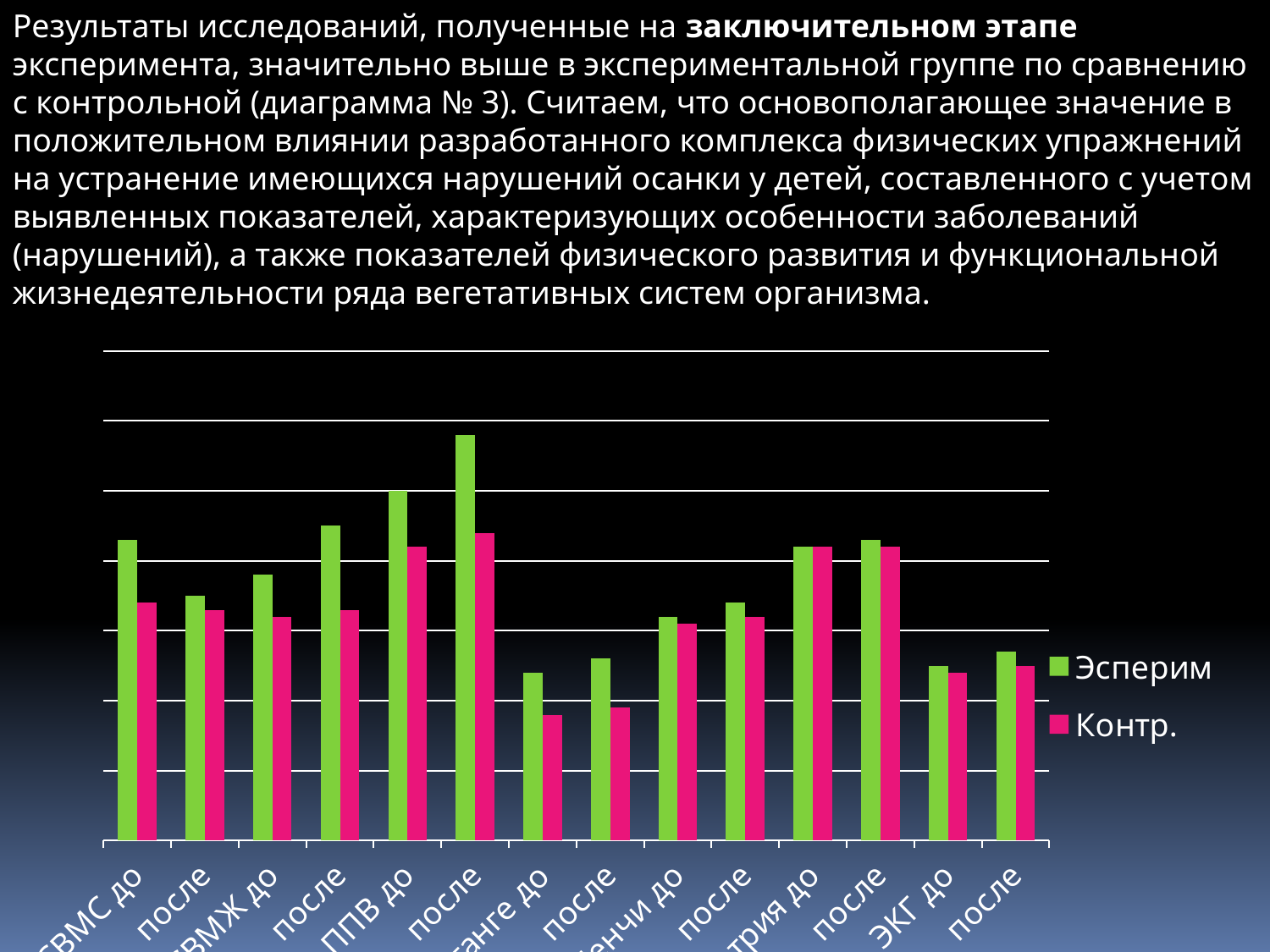
Which series is shown in green in the chart? Эсперим Which category has the highest Эсперим value in the chart? the 'после' category immediately after 'ППВ до' What kind of chart is shown on the slide? bar chart For the 'после' category immediately following 'ППВ до', which series has the larger value, Эсперим or Контр.? Эсперим Which series is shown in pink in the chart? Контр. For the category 'ППВ до', which series has the larger value, Эсперим or Контр.? Эсперим How many categories are shown along the x axis of the chart? 14 For the 'после' category immediately following 'ЭКГ до', which series has the larger value, Эсперим or Контр.? Эсперим Which category has the highest Контр. value in the chart? the 'после' category immediately after 'ППВ до' How many series does the legend list? 2